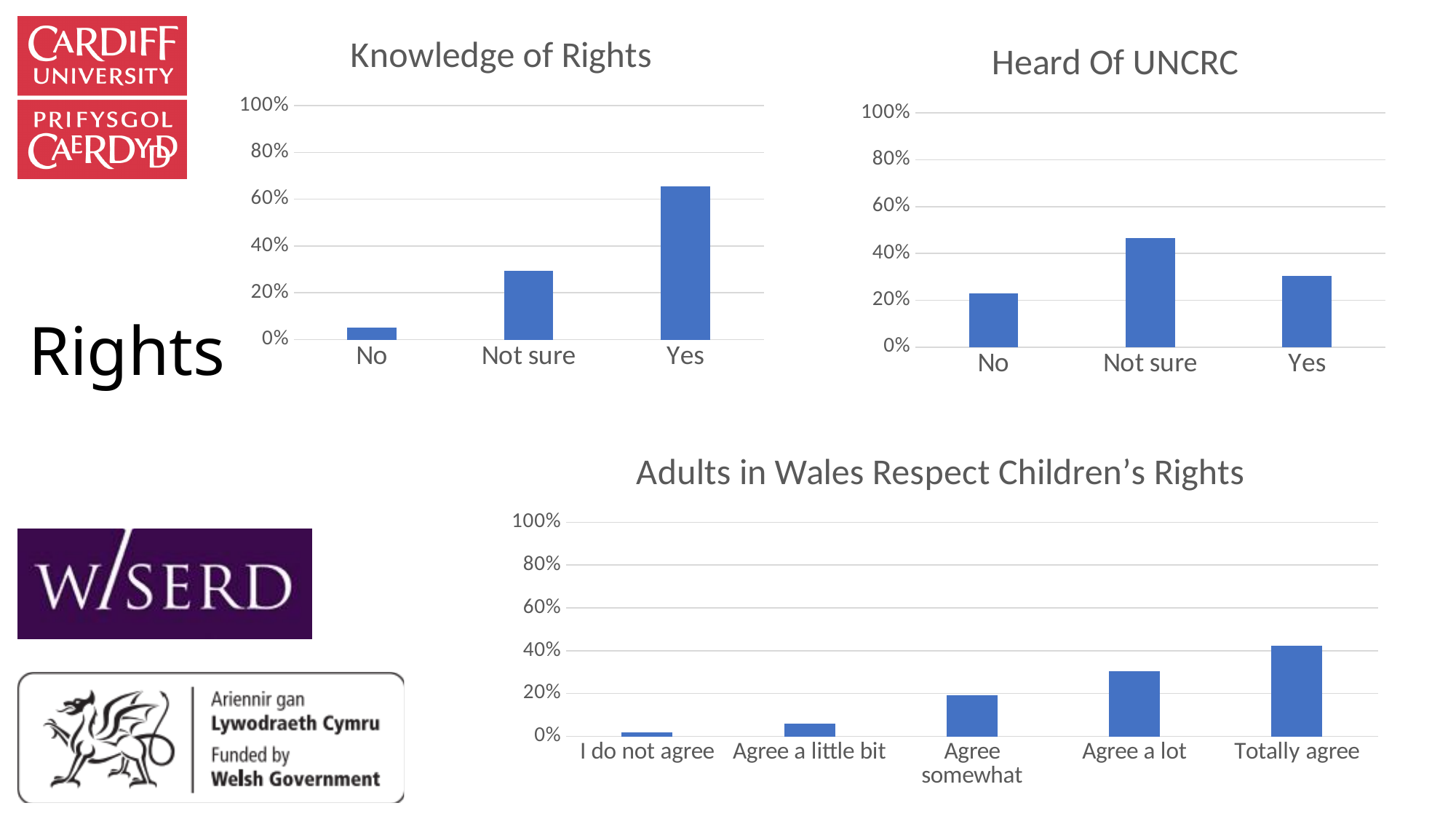
In the 'Heard Of UNCRC' chart, which category has the lowest value? No In the 'Knowledge of Rights' chart, which category has the lowest value? No In the 'Knowledge of Rights' chart, is the value for Yes greater or less than 60%? greater In the 'Heard Of UNCRC' chart, is the value for Not sure greater or less than 40%? greater In the 'Adults in Wales Respect Children's Rights' chart, how many categories are shown on the x axis? 5 In the 'Heard Of UNCRC' chart, which is larger, the value for Yes or the value for No? Yes In the 'Adults in Wales Respect Children's Rights' chart, do the values rise or fall from left to right along the x axis? rise In the 'Heard Of UNCRC' chart, which category has the highest value? Not sure What kind of chart is the 'Heard Of UNCRC' chart? bar chart In the 'Knowledge of Rights' chart, is the value for Not sure greater or less than 40%? less In the 'Adults in Wales Respect Children's Rights' chart, which category has the highest value? Totally agree In the 'Knowledge of Rights' chart, which category has the highest value? Yes